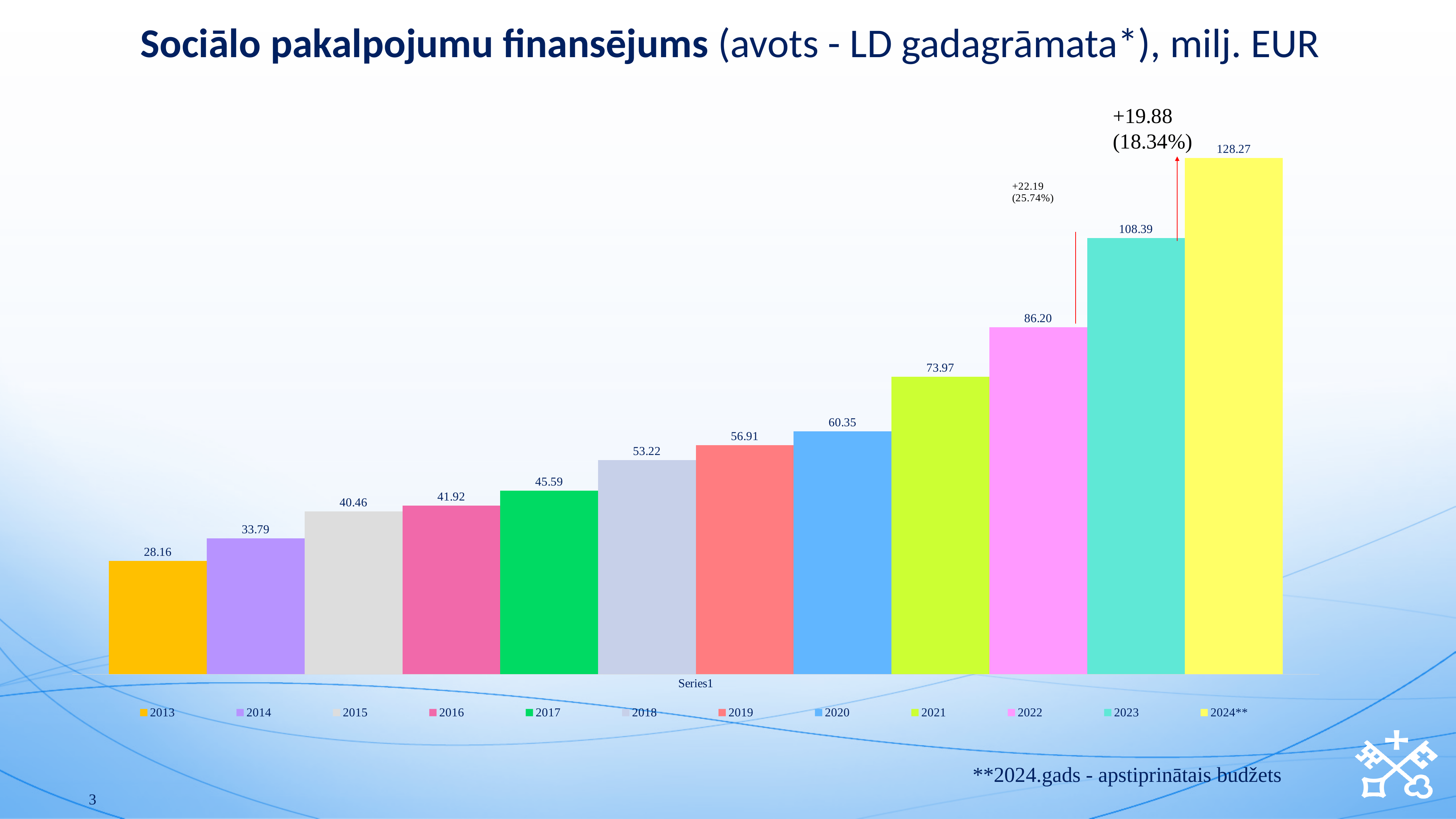
Do the values rise or fall from 2013 to 2024**? rise Which is larger, the value for 2021 or the value for 2020? 2021 How many bars are shown in the chart? 12 What kind of chart is shown on the slide? bar chart What is the value for 2023? 108.39 What is the value for 2013? 28.16 What is the value for 2018? 53.22 What is the value for 2024**? 128.27 Which year has the highest value? 2024** What is the difference between the values for 2023 and 2022? 22.19 Which year has the lowest value? 2013 What is the difference between the values for 2024** and 2023? 19.88